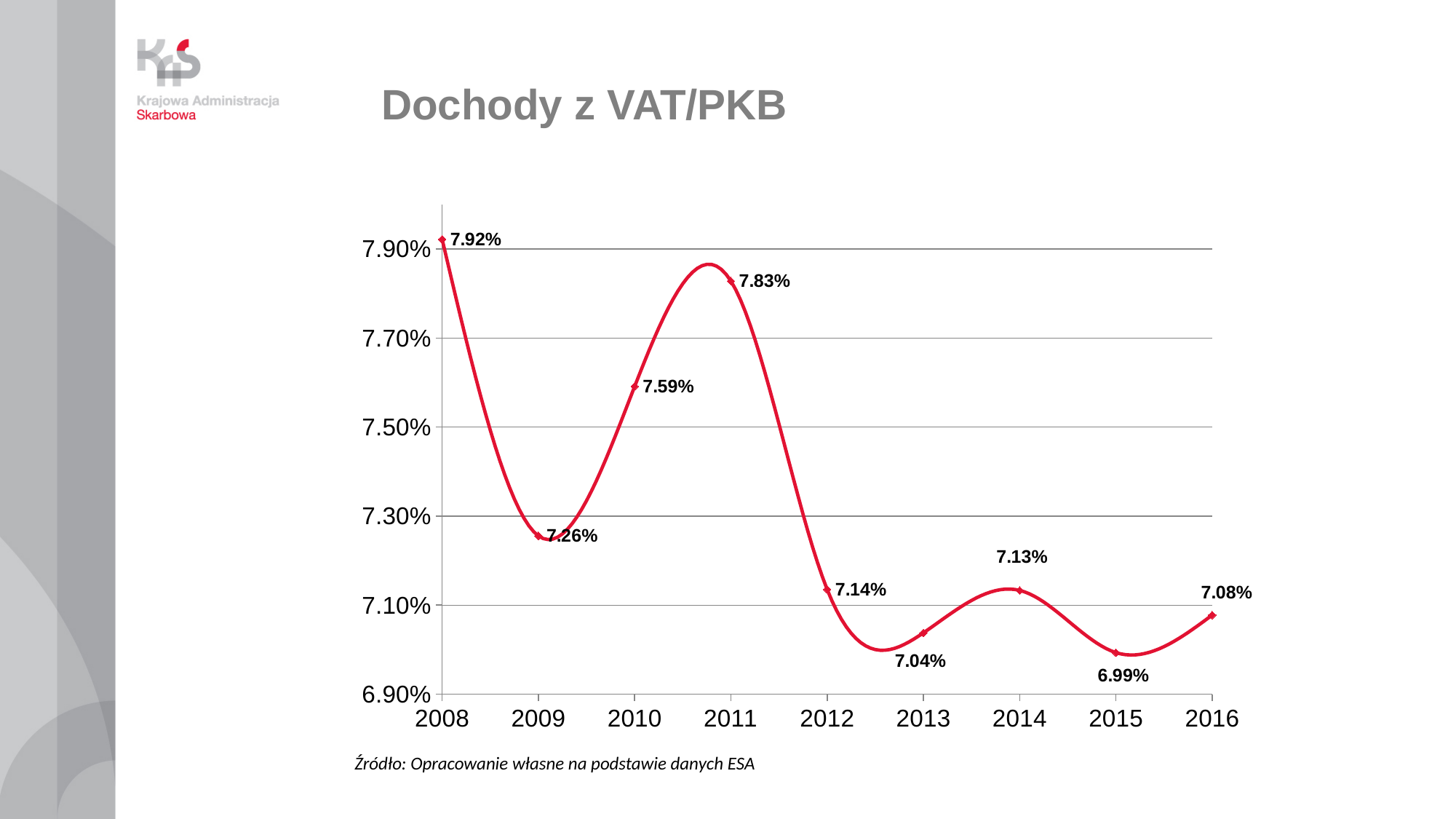
How many years are plotted on the chart? 9 What is the value for 2015? 6.99% Which year has the highest value? 2008 What is the value for 2008? 7.92% What is the title of the chart? Dochody z VAT/PKB What is the difference between the values for 2008 and 2009? 0.66% Which is larger, the value for 2010 or the value for 2011? 2011 What is the value for 2016? 7.08% What kind of chart is shown on the slide? line chart Which year has the lowest value? 2015 What is the difference between the values for 2011 and 2012? 0.69% What is the value for 2011? 7.83%